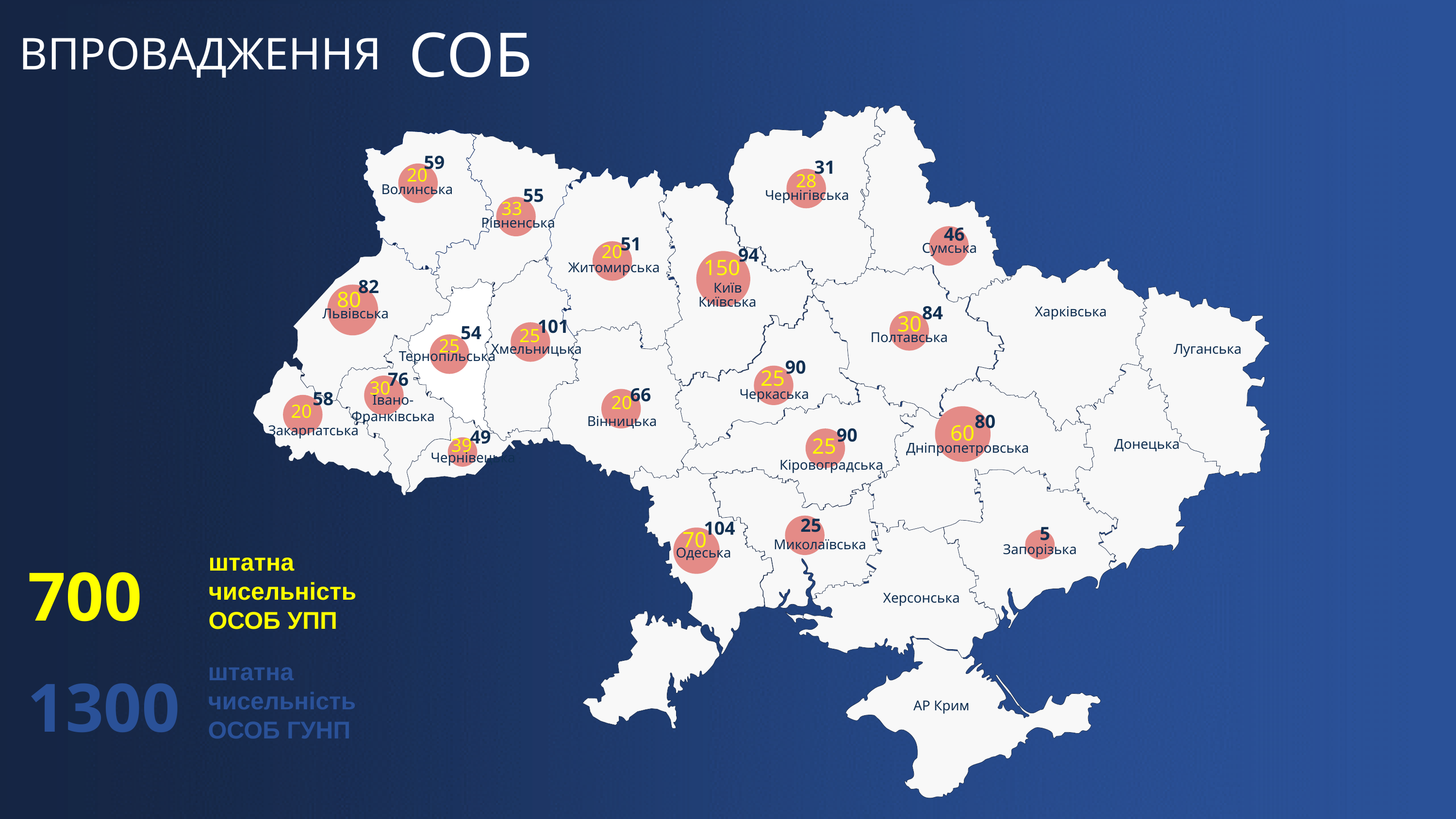
What is the dark number shown next to the bubble for Одеська? 104 What total staffing number (штатна чисельність ОСОБ ГУНП) is shown in blue at the bottom left? 1300 Which has the larger yellow bubble value, Львівська or Дніпропетровська? Львівська What total staffing number (штатна чисельність ОСОБ УПП) is shown in yellow at the bottom left? 700 Which region has the highest yellow bubble value on the map? Київ / Київська What is the difference between the dark number (104) and the yellow value (70) for Одеська? 34 How many regions on the map have a bubble marker? 20 What is the yellow value shown in the bubble for Дніпропетровська? 60 What kind of chart is shown on the slide? Bubble map Which region has the lowest dark number on the map? Запорізька What is the yellow value shown in the bubble for Київ / Київська? 150 What is the dark number shown for Хмельницька? 101